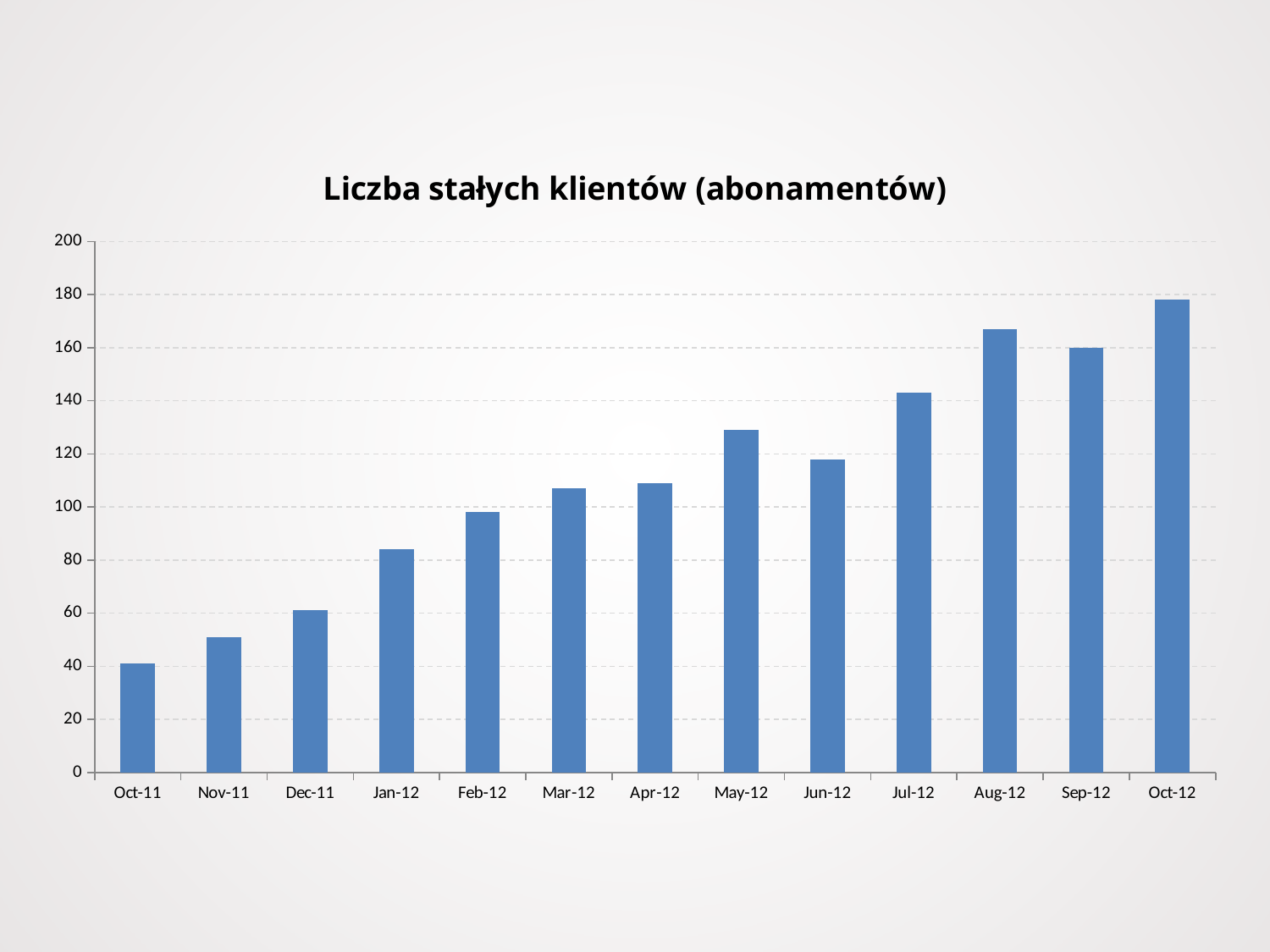
Which is larger, the value for May-12 or the value for Jun-12? May-12 Which month has the highest value? Oct-12 How many months (categories) are shown on the x axis? 13 What type of chart is shown on the slide? bar chart Is the value for Jan-12 greater or less than 80? greater What is the title of the chart? Liczba stałych klientów (abonamentów) Which month has the lowest value? Oct-11 Is the value for Jul-12 greater or less than 140? greater Do the values generally rise or fall from Oct-11 to Oct-12? rise Is the value for Oct-11 greater or less than 60? less